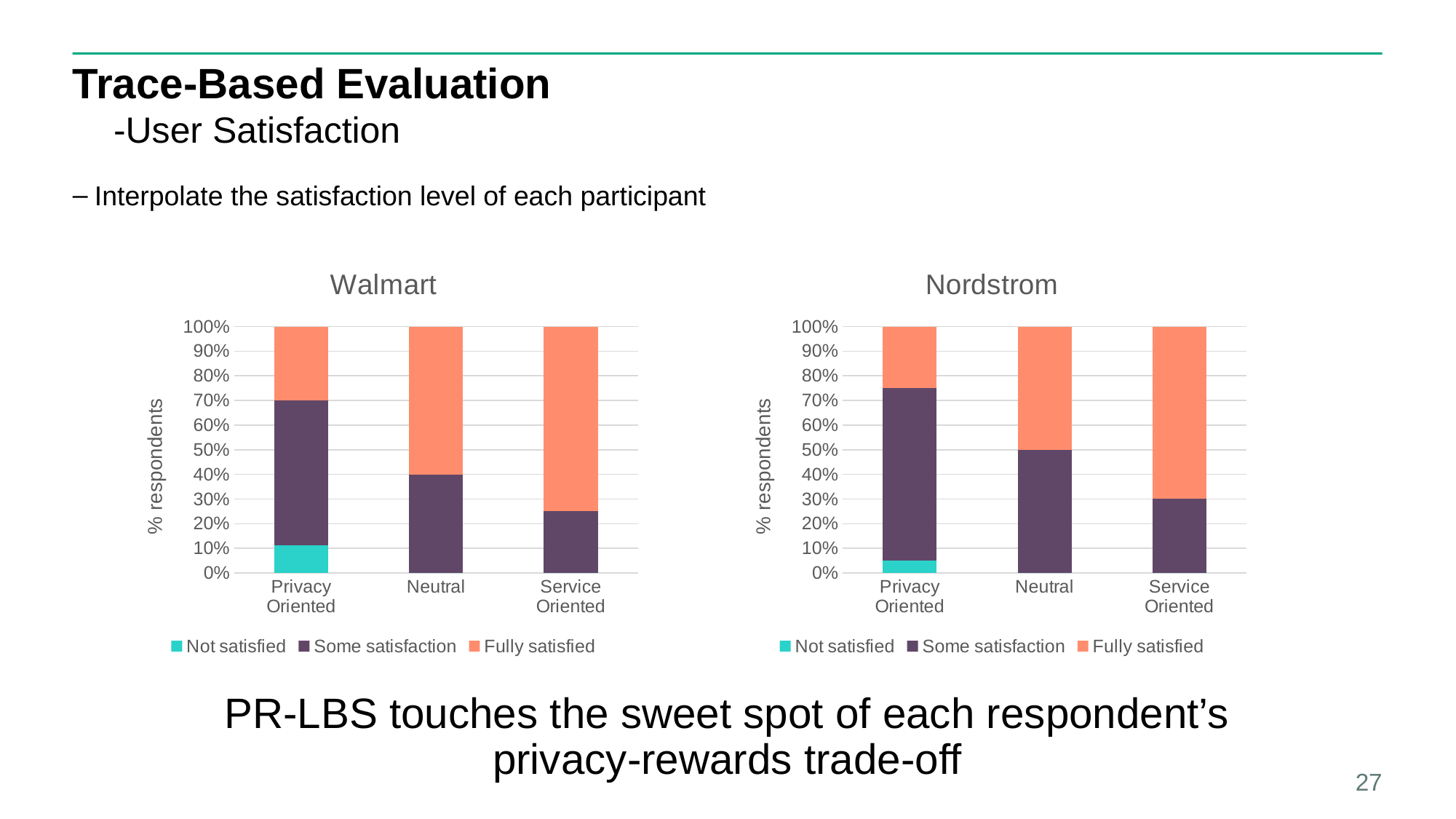
In the Nordstrom chart, what percentage of Neutral respondents reported some satisfaction? 50% In the Walmart chart, what percentage of Neutral respondents reported some satisfaction? 40% In the Walmart chart, which category has the largest Fully satisfied share? Service Oriented What kind of chart is the Nordstrom chart? stacked bar chart In the Walmart chart, which has a larger Some satisfaction share: Neutral or Service Oriented? Neutral In the Nordstrom chart, is the Not satisfied share for Privacy Oriented respondents greater or less than 10%? less In the Nordstrom chart, what percentage of Service Oriented respondents were fully satisfied? 70% In the Walmart chart, is the Not satisfied share for Privacy Oriented respondents greater or less than 20%? less In the Nordstrom chart, does the Some satisfaction share rise or fall from Privacy Oriented to Service Oriented? fall How many series does the legend of the Walmart chart list? 3 In the Nordstrom chart, which category has the smallest Fully satisfied share? Privacy Oriented In the Nordstrom chart, what percentage of Service Oriented respondents reported some satisfaction? 30%